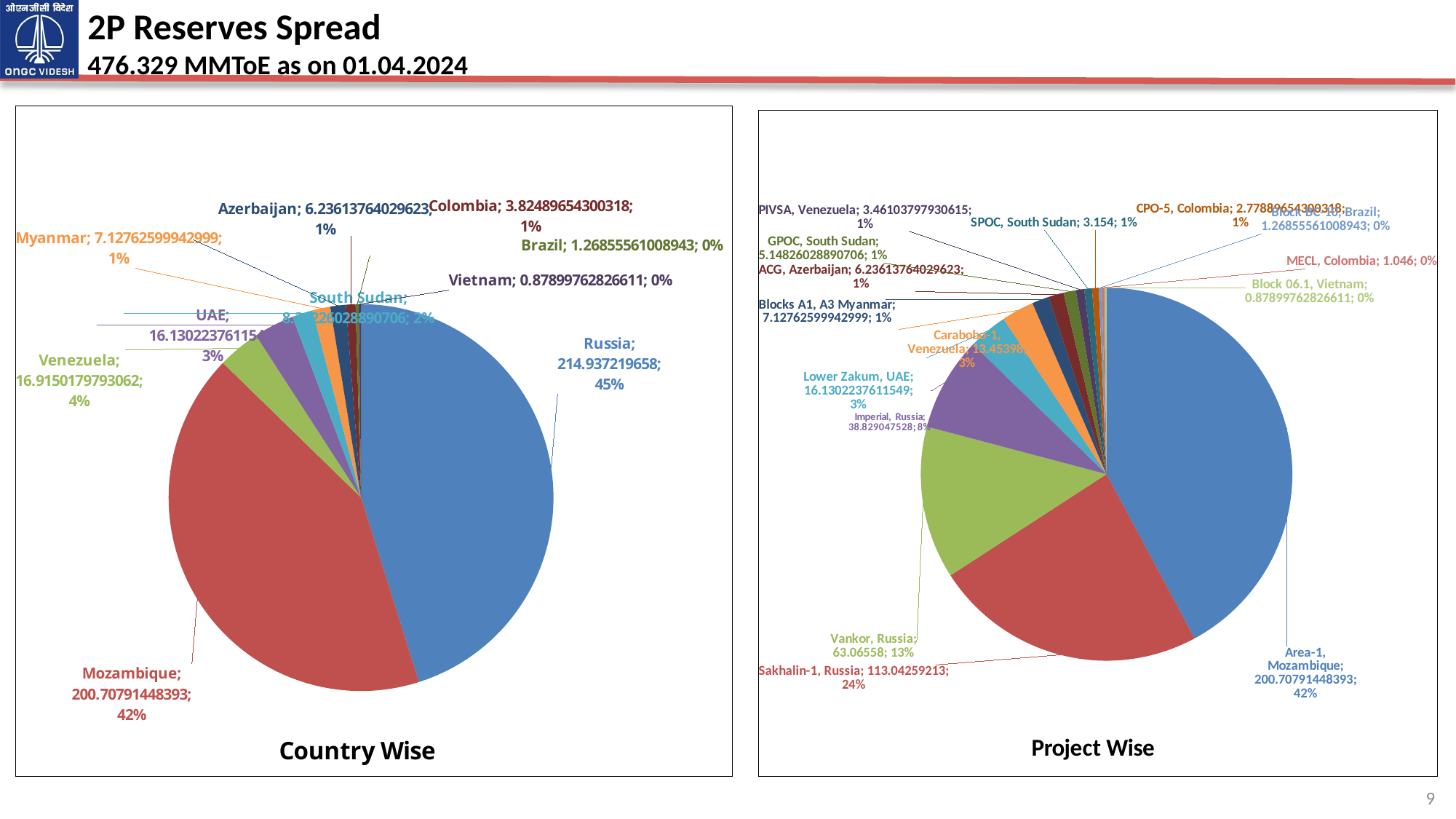
On the Project Wise chart, what share of the pie does Vankor, Russia hold? 13% On the Country Wise chart, which country has the smallest value? Vietnam What kind of chart is the Country Wise chart? Pie chart On the Project Wise chart, what is the difference between the values for Sakhalin-1, Russia and Vankor, Russia? 49.97701213 On the Project Wise chart, which project has the largest slice? Area-1, Mozambique On the Country Wise chart, what is the difference between the values for Russia and Mozambique? 14.22930517407 On the Country Wise chart, how many countries are shown? 10 On the Project Wise chart, what is the value for Sakhalin-1, Russia? 113.04259213 On the Country Wise chart, what share of the pie does Mozambique hold? 42% On the Country Wise chart, what is the value for Russia? 214.937219658 On the Country Wise chart, which country has the largest slice? Russia On the Project Wise chart, which is larger: Vankor, Russia or Imperial, Russia? Vankor, Russia